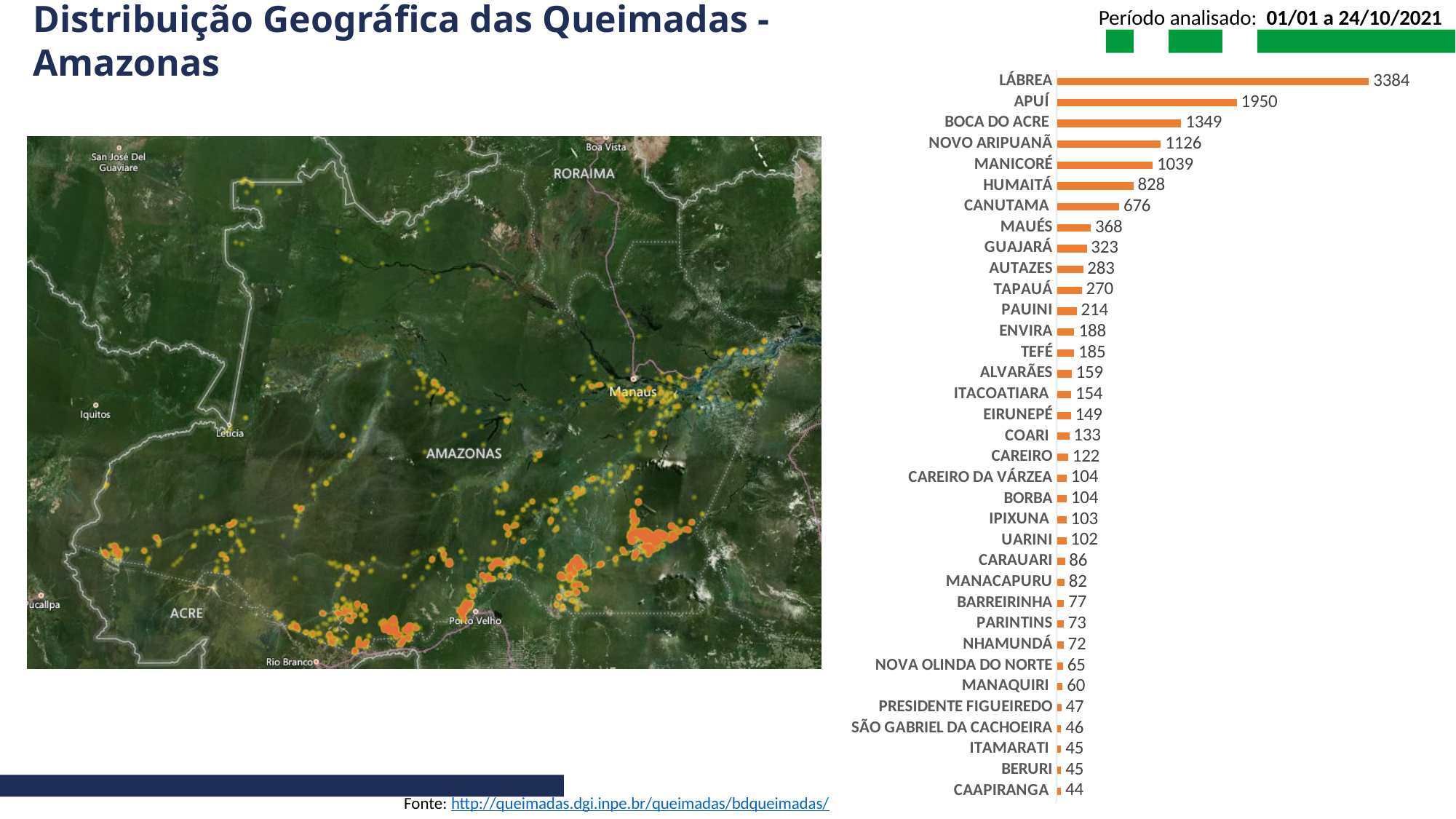
In the bar chart, what is the value for ITACOATIARA? 154 What period is stated as analysed on the slide? 01/01 a 24/10/2021 In the bar chart, what is the difference between the values for LÁBREA and APUÍ? 1434 In the bar chart, what is the difference between the values for BOCA DO ACRE and NOVO ARIPUANÃ? 223 In the bar chart, which municipality has the lowest value? CAAPIRANGA In the bar chart, which municipality has the highest value? LÁBREA In the bar chart, what is the value for LÁBREA? 3384 In the bar chart, which has a larger value, MANICORÉ or CANUTAMA? MANICORÉ In the bar chart, which has a larger value, MAUÉS or TAPAUÁ? MAUÉS How many municipalities are listed in the bar chart? 35 In the bar chart, what is the value for HUMAITÁ? 828 What kind of chart is shown on the right side of the slide? Bar chart